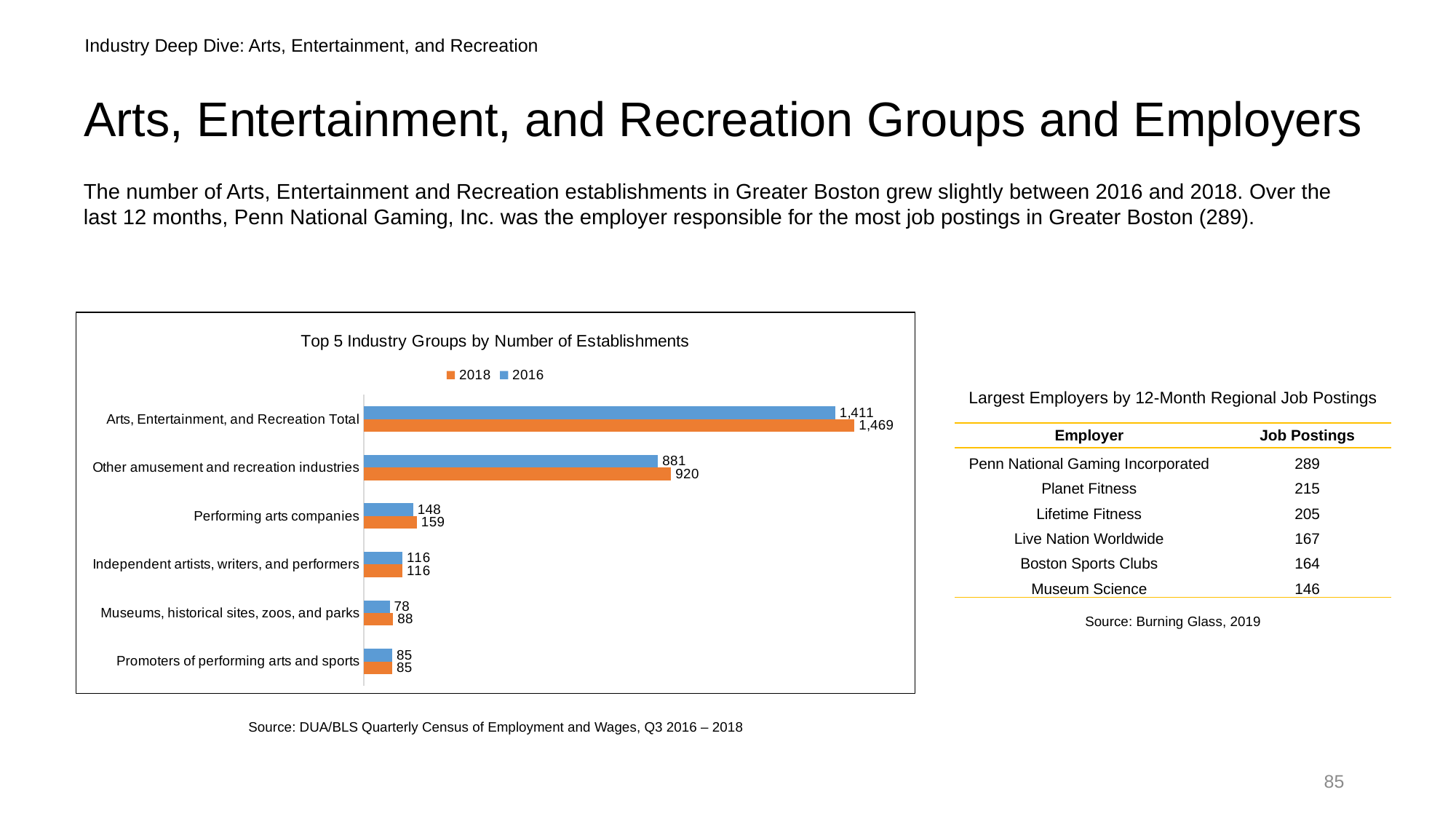
What type of chart is used for Top 5 Industry Groups by Number of Establishments? bar chart How many series does the legend of the Top 5 Industry Groups chart list? 2 Which colour represents the 2018 series in the Top 5 Industry Groups chart? orange Excluding the Total, which industry group had the most establishments in 2018? Other amusement and recreation industries What was the number of establishments for Performing arts companies in 2016? 148 How many industry group categories are shown on the Top 5 Industry Groups chart? 6 What was the 2016 value for Arts, Entertainment, and Recreation Total? 1,411 Which industry group had the fewest establishments in 2016? Museums, historical sites, zoos, and parks Which is larger: the 2018 value for Promoters of performing arts and sports or the 2018 value for Museums, historical sites, zoos, and parks? Museums, historical sites, zoos, and parks By how much did the Arts, Entertainment, and Recreation Total increase from 2016 to 2018? 58 What was the 2018 value for Museums, historical sites, zoos, and parks? 88 What was the number of establishments for Other amusement and recreation industries in 2018? 920